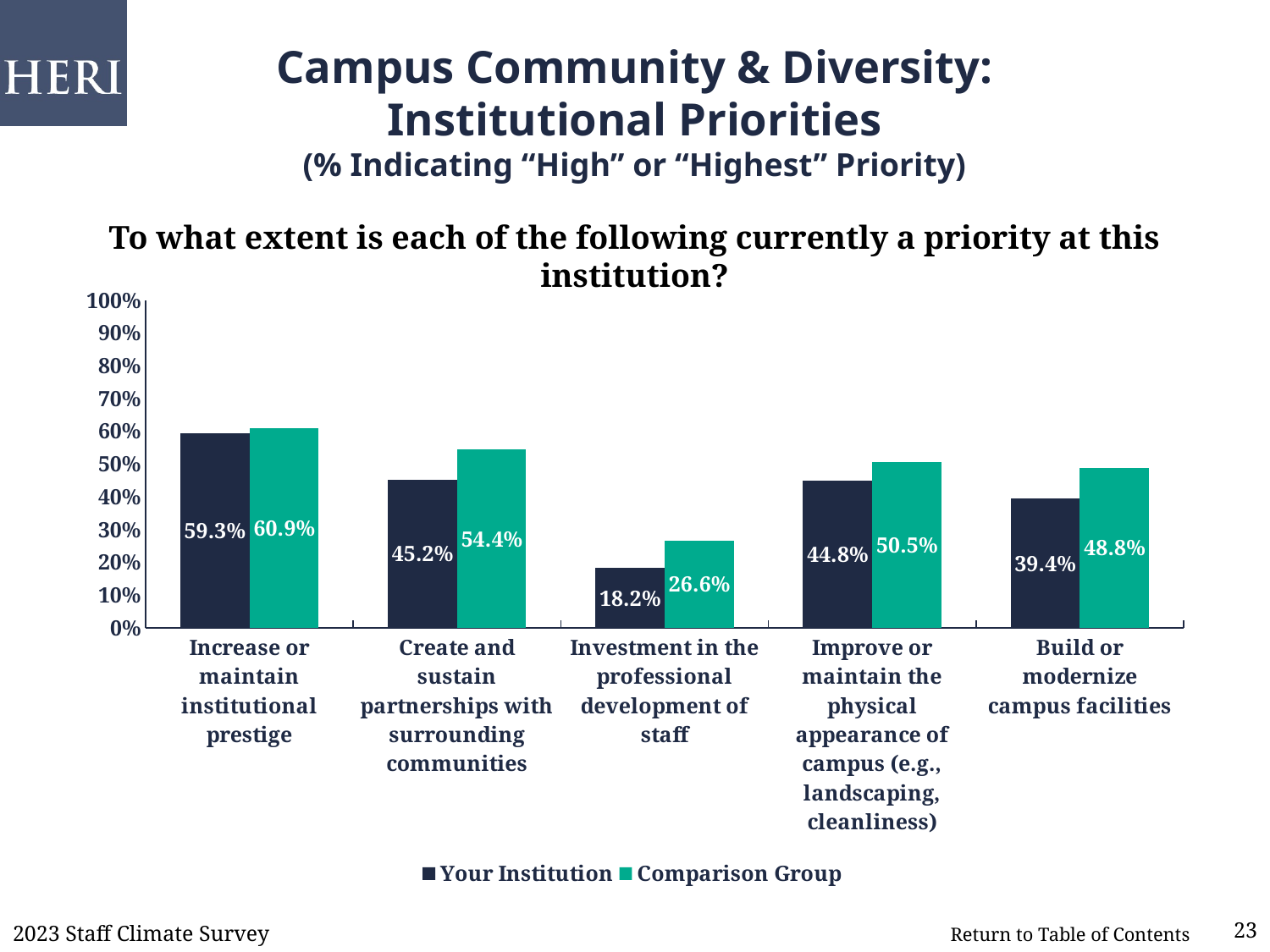
Which series is shown in green in the legend? Comparison Group What is the value for Your Institution for "Increase or maintain institutional prestige"? 59.3% Which category has the highest value for Comparison Group? Increase or maintain institutional prestige How many categories are shown on the x axis? 5 What is the value for Your Institution for "Build or modernize campus facilities"? 39.4% Is the value for Your Institution for "Investment in the professional development of staff" greater or less than 20%? less What kind of chart is shown on the slide? Bar chart Which is larger for "Improve or maintain the physical appearance of campus": Your Institution or Comparison Group? Comparison Group What is the value for Comparison Group for "Investment in the professional development of staff"? 26.6% What is the difference between Comparison Group and Your Institution for "Create and sustain partnerships with surrounding communities"? 9.2% How many series does the legend list? 2 Which category has the lowest value for Your Institution? Investment in the professional development of staff